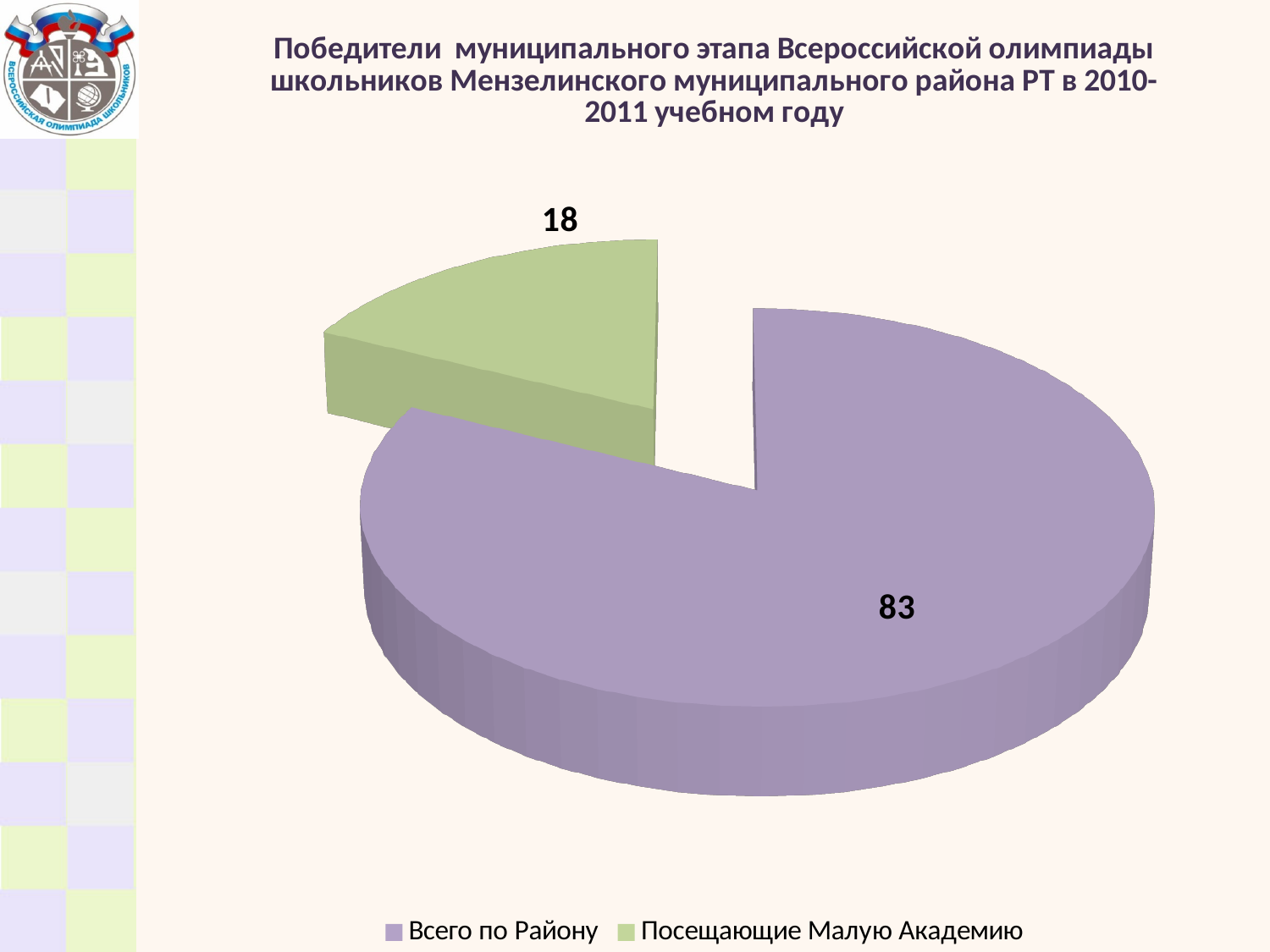
What is the value for "Посещающие Малую Академию"? 18 Which slice of the pie is the largest? Всего по Району Which is larger: "Всего по Району" or "Посещающие Малую Академию"? Всего по Району Which school year does the chart title refer to? 2010-2011 учебном году What is the value for "Всего по Району"? 83 How many entries does the legend list? 2 Which slice of the pie is the smallest? Посещающие Малую Академию What is the difference between the values for "Всего по Району" and "Посещающие Малую Академию"? 65 How many slices does the pie chart have? 2 What type of chart is shown on the slide? Pie chart What colour is the slice for "Посещающие Малую Академию"? Green What is the sum of the two values shown on the pie chart? 101